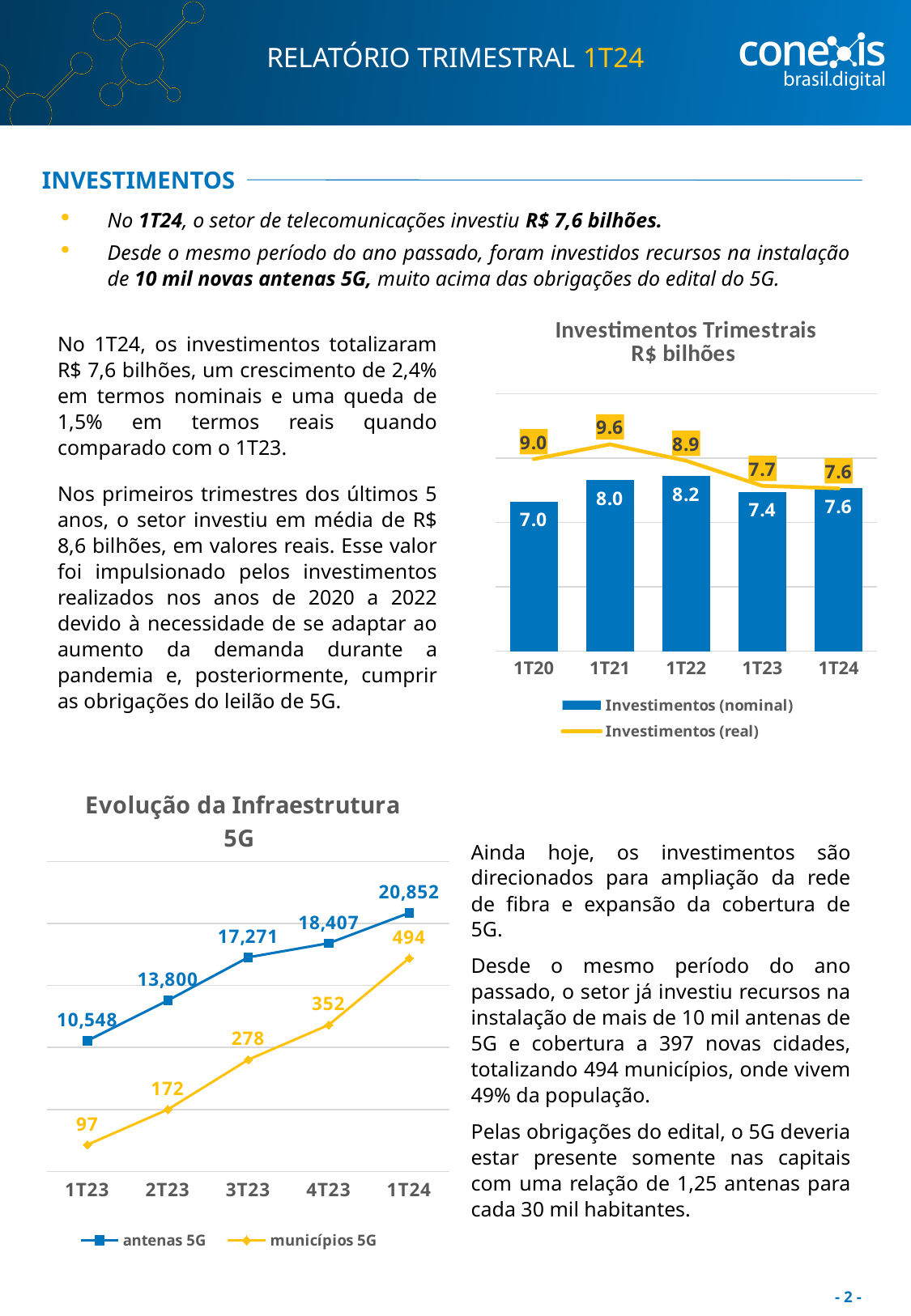
In the 'Evolução da Infraestrutura 5G' chart, what is the difference in antenas 5G between 1T24 and 1T23? 10,304 In the 'Investimentos Trimestrais' chart, what is the value of Investimentos (real) for 1T21? 9.6 In the 'Evolução da Infraestrutura 5G' chart, do the municípios 5G values rise or fall from 1T23 to 1T24? rise In the 'Investimentos Trimestrais' chart, which period has the lowest Investimentos (nominal) value? 1T20 In the 'Evolução da Infraestrutura 5G' chart, what is the value of municípios 5G for 3T23? 278 In the 'Evolução da Infraestrutura 5G' chart, what is the value of antenas 5G for 1T24? 20,852 In the 'Investimentos Trimestrais' chart, what is the difference between Investimentos (real) and Investimentos (nominal) in 1T20? 2.0 In the 'Investimentos Trimestrais' chart, how many series does the legend list? 2 In the 'Investimentos Trimestrais' chart, what is the value of Investimentos (nominal) for 1T24? 7.6 What kind of chart is 'Evolução da Infraestrutura 5G'? line chart In the 'Investimentos Trimestrais' chart, which period has the highest Investimentos (nominal) value? 1T22 In the 'Evolução da Infraestrutura 5G' chart, how many periods are shown on the x axis? 5